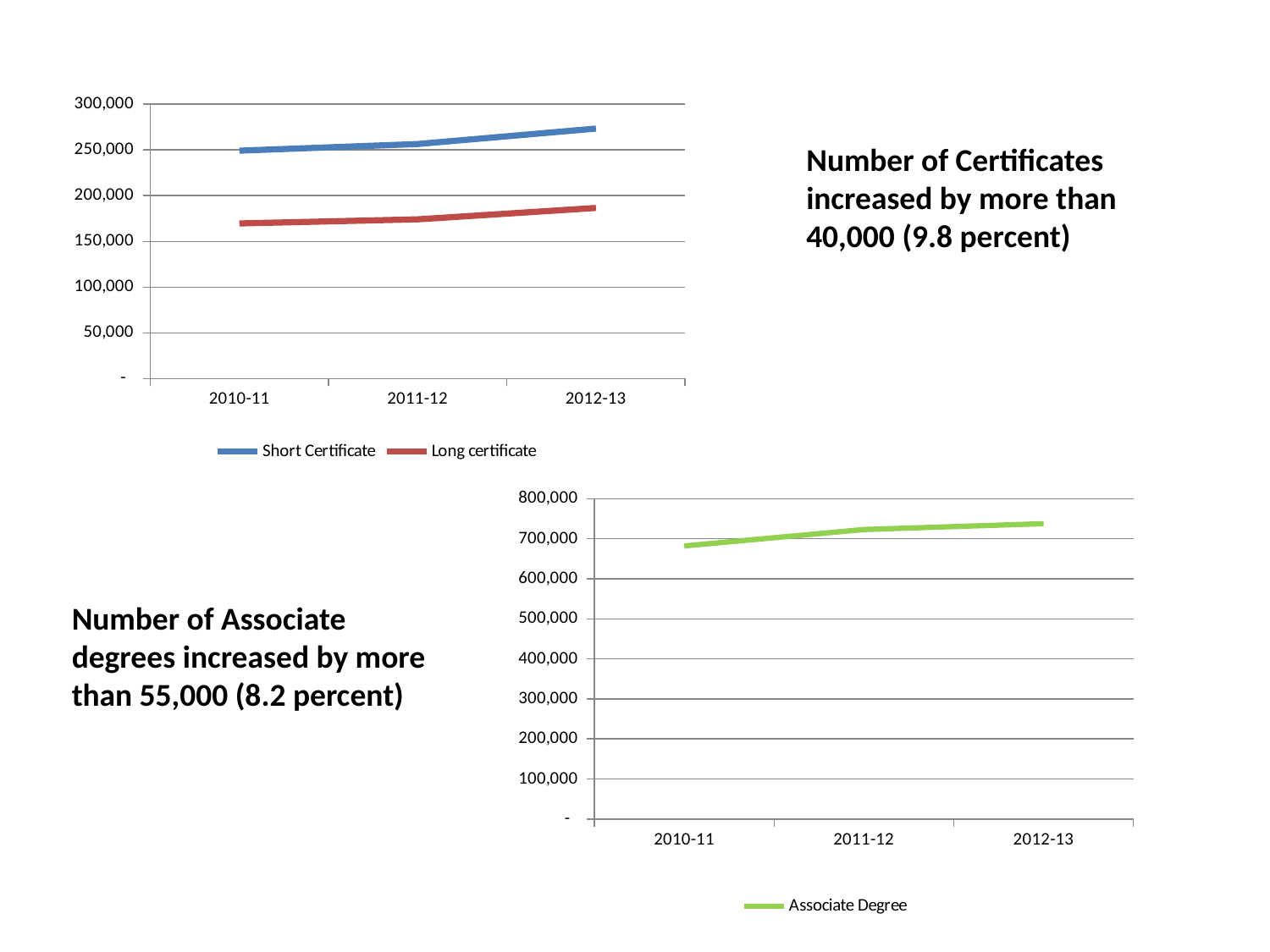
In the bottom-right chart, does the Associate Degree line rise or fall across the years shown? rise In the top-left chart, is the value for Short Certificate in 2012-13 greater or less than 250,000? greater In the bottom-right chart, is the value for Associate Degree in 2012-13 greater or less than 700,000? greater What colour is the Long certificate line in the top-left chart? red How many years are shown on the x axis of the top-left chart? 3 In the top-left chart, which series has higher values in 2012-13, Short Certificate or Long certificate? Short Certificate How many series does the legend of the top-left chart list? 2 In the top-left chart, does the Short Certificate line rise or fall from 2010-11 to 2012-13? rise What is the only series listed in the legend of the bottom-right chart? Associate Degree What type of chart is the top-left chart on the slide? line chart In the top-left chart, is the value for Long certificate in 2010-11 greater or less than 200,000? less